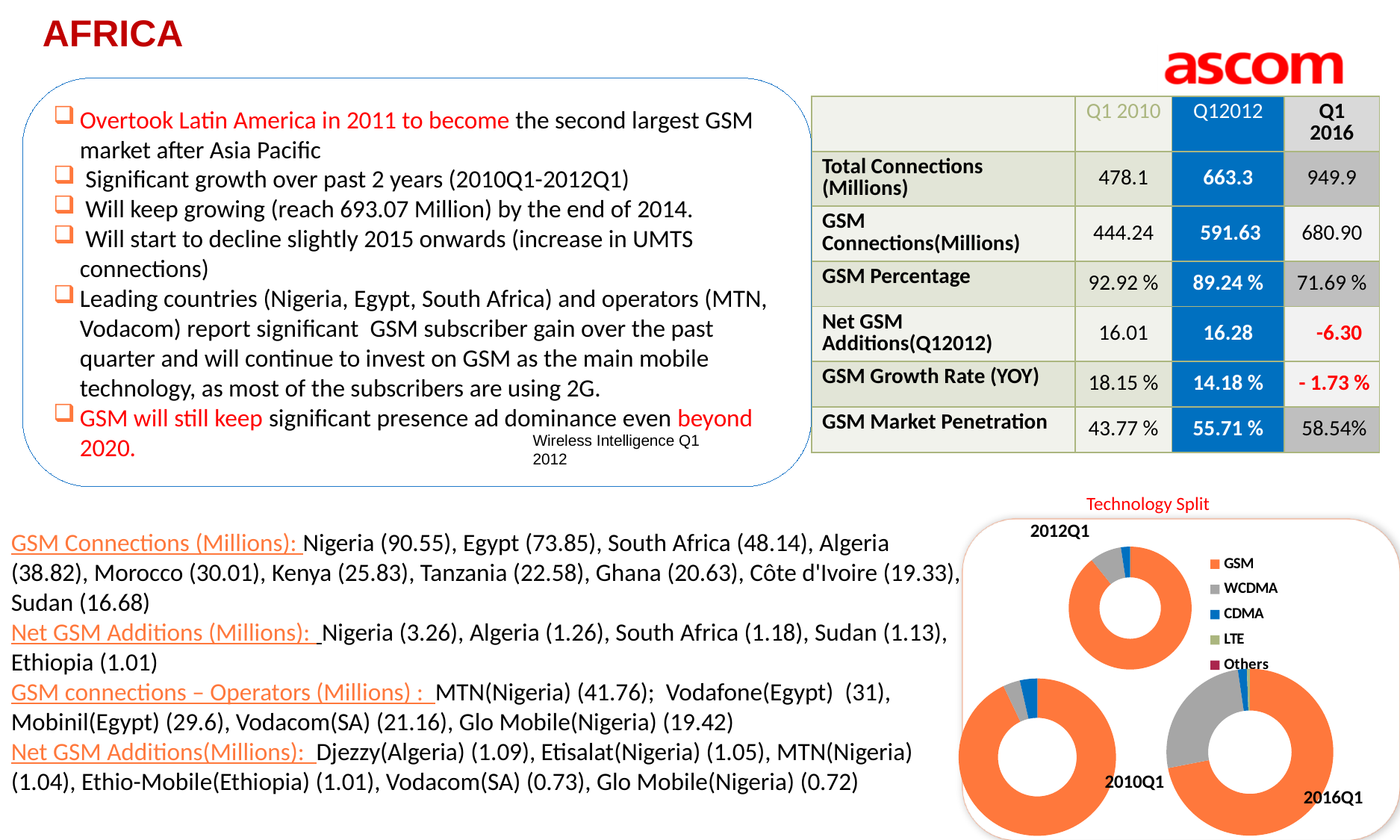
Which colour represents GSM in the Technology Split charts? Orange In the Technology Split chart for 2012Q1, which is larger, the WCDMA share or the CDMA share? WCDMA What kind of chart is used in the Technology Split section of the slide? Pie (donut) chart Which of the three Technology Split charts shows the largest WCDMA share? 2016Q1 Across the Technology Split charts from 2010Q1 to 2016Q1, does the WCDMA share rise or fall? Rise In the Technology Split chart for 2016Q1, which technology has the largest share? GSM Across the Technology Split charts from 2010Q1 to 2016Q1, does the GSM share rise or fall? Fall How many series does the legend of the Technology Split charts list? 5 In the Technology Split chart for 2010Q1, which technology has the largest share? GSM In the Technology Split chart for 2016Q1, which is larger, the GSM share or the WCDMA share? GSM How many donut charts are shown in the Technology Split section? 3 What is the title shown above the donut charts on the slide? Technology Split